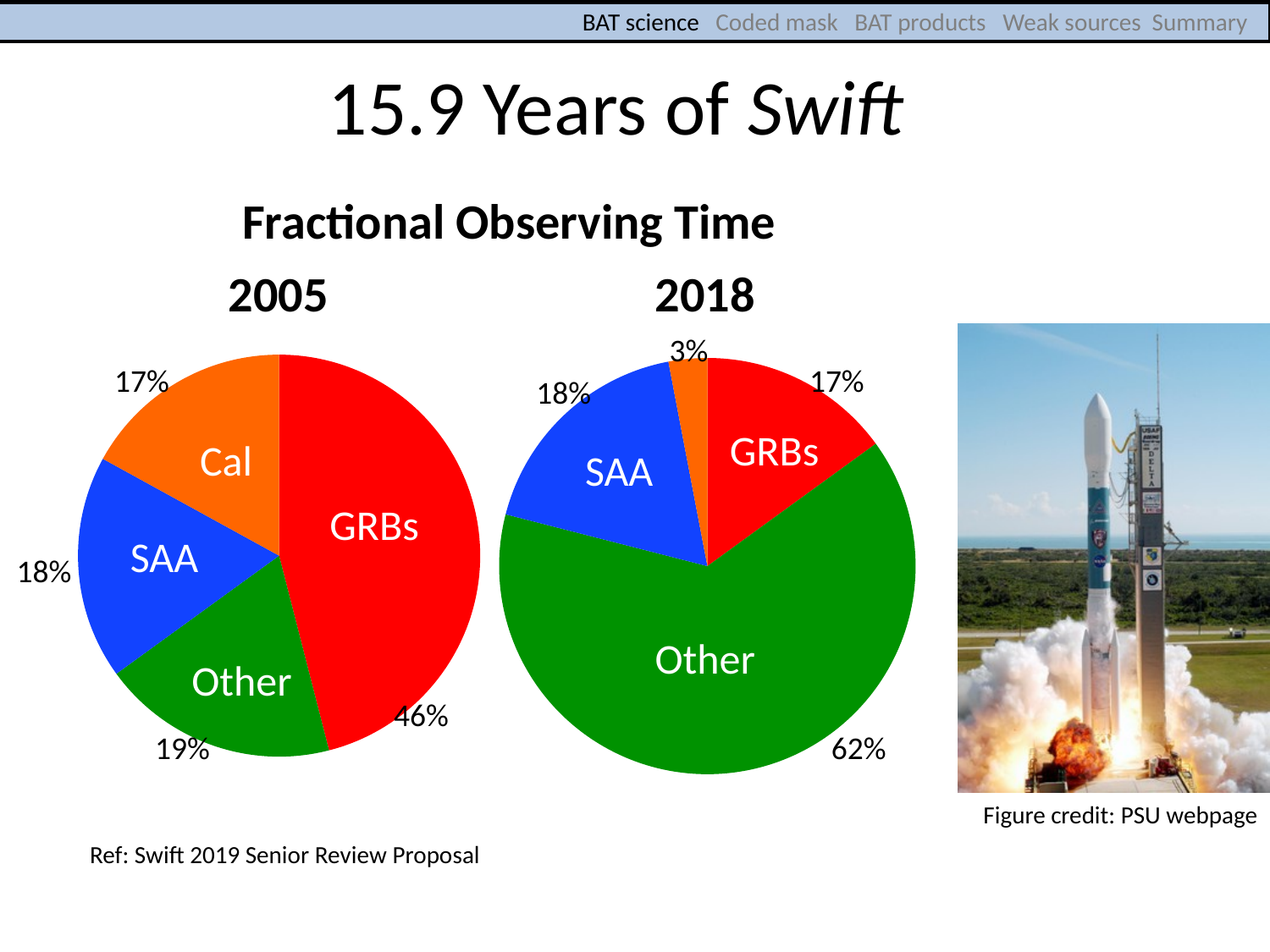
In the 2018 pie chart, what percentage of observing time is for Other? 62% What type of chart is used to show the 2018 fractional observing time? Pie chart In the 2005 pie chart, what percentage of observing time is for GRBs? 46% How many slices does the 2005 pie chart have? 4 In the 2005 pie chart, what percentage is labelled for Cal? 17% In the 2018 pie chart, what percentage is labelled for SAA? 18% What is the overall title above the two pie charts? Fractional Observing Time What is the difference between the GRBs share in the 2005 pie chart and the GRBs share in the 2018 pie chart? 29% In the 2005 pie chart, which labelled category has the smallest share? Cal In the 2005 pie chart, which is larger, the share for Other or the share for SAA? Other In the 2018 pie chart, which category has the largest share? Other In the 2005 pie chart, which category has the largest share? GRBs